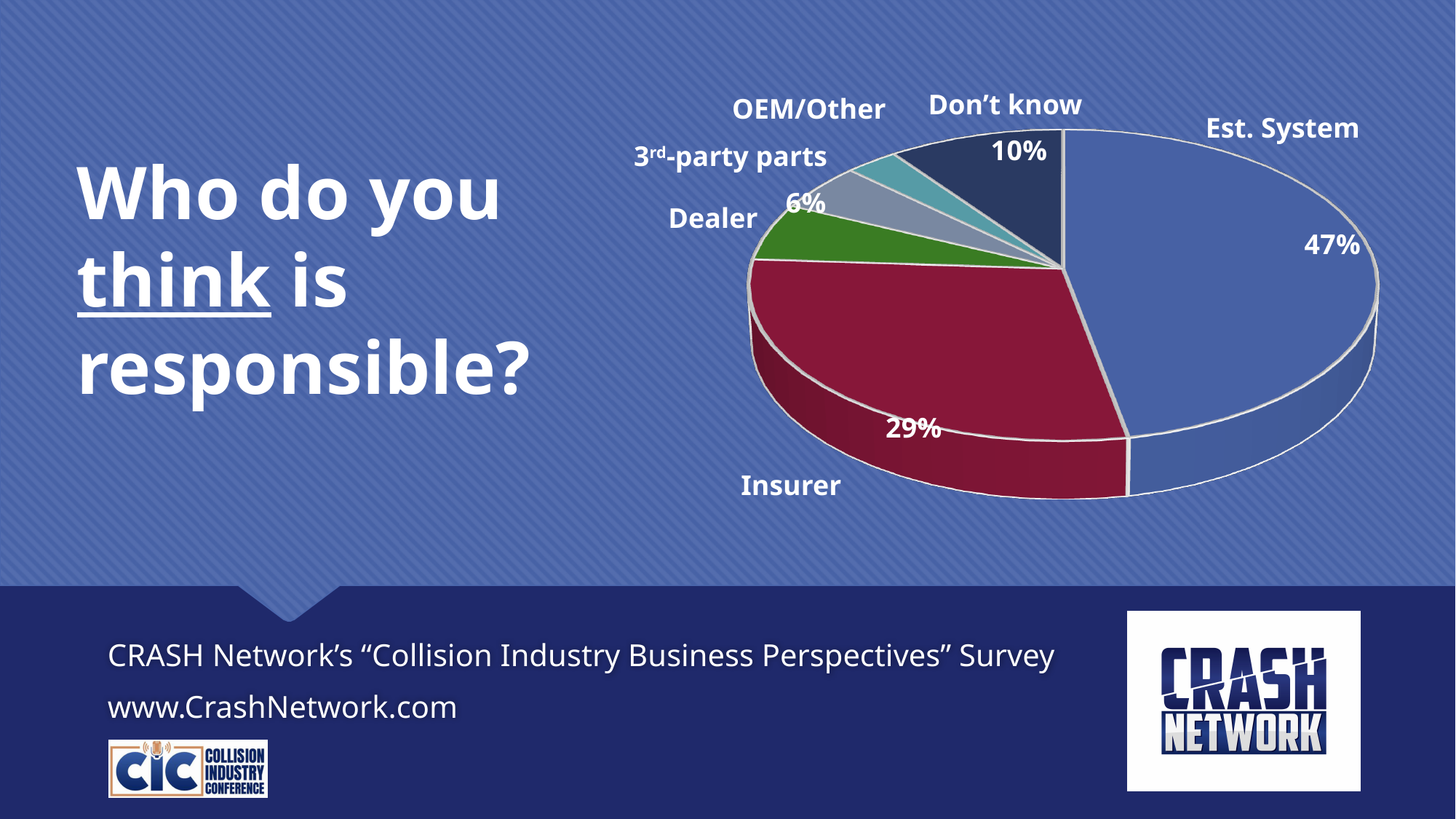
What is the difference in percentage points between Est. System and Insurer? 18% What percentage of respondents said Insurer is responsible? 29% Which category has the largest slice of the pie? Est. System What is the difference in percentage points between Insurer and Don't know? 19% Which is larger, the Dealer slice or the Insurer slice? Insurer What percentage of respondents answered Don't know? 10% What colour is the Insurer slice of the pie? red What question does the slide title ask? Who do you think is responsible? What kind of chart is shown on the slide? pie chart Which is larger, the Insurer slice or the Don't know slice? Insurer How many categories are shown in the pie chart? 6 What percentage of respondents said Est. System is responsible? 47%